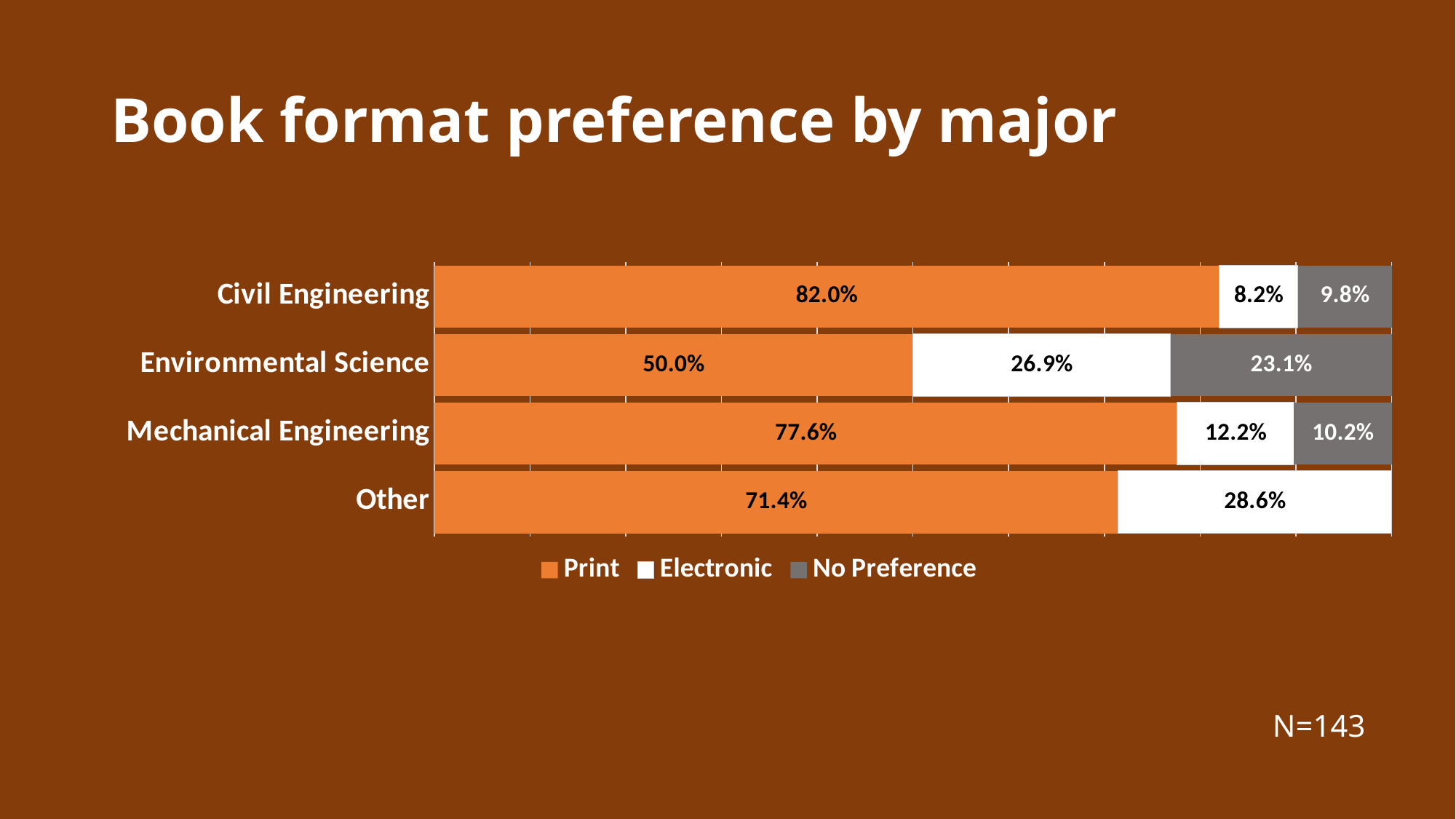
Which is larger, the Electronic value for Mechanical Engineering or the Electronic value for Civil Engineering? Mechanical Engineering What is the Electronic value for Environmental Science? 26.9% What kind of chart is shown on the slide? Stacked bar chart Which major has the lowest Print percentage? Environmental Science Which major has the highest Print percentage? Civil Engineering What percentage of Civil Engineering students prefer Print? 82.0% What is the No Preference value for Mechanical Engineering? 10.2% What is the Electronic value for Other? 28.6% How many series does the legend list? 3 What is the title of the chart? Book format preference by major What is the difference between the Print percentages for Civil Engineering and Mechanical Engineering? 4.4% How many majors are shown on the chart? 4